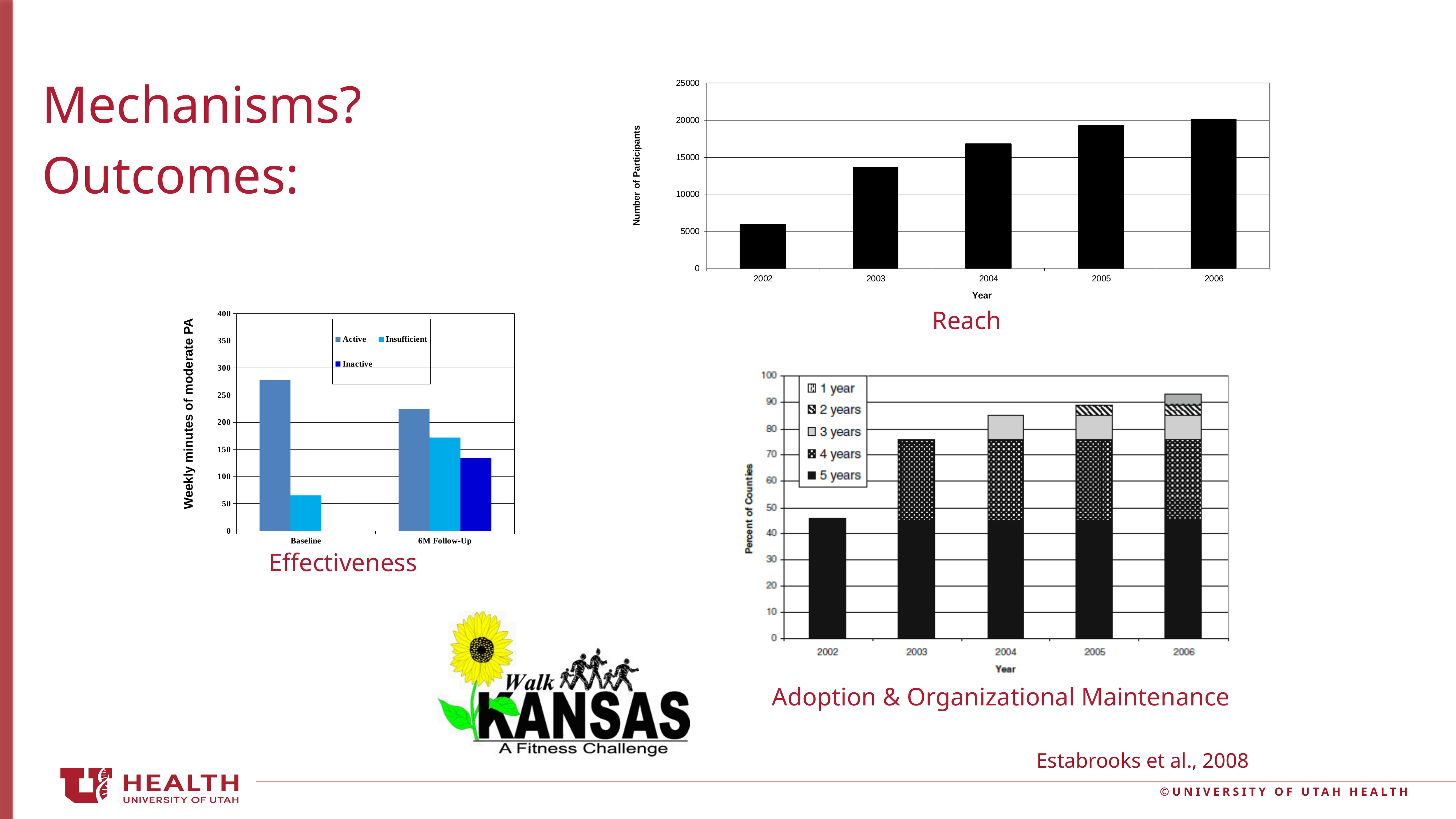
In the Reach chart, which year has the highest number of participants? 2006 In the Reach chart, which year has the lowest number of participants? 2002 How many series does the legend of the Effectiveness chart list? 3 How many series does the legend of the Adoption & Organizational Maintenance chart list? 5 In the Effectiveness chart, at 6M Follow-Up, which is larger: Active or Inactive? Active What kind of chart is the Adoption & Organizational Maintenance chart? stacked bar chart How many years are shown on the x axis of the Reach chart? 5 In the Reach chart, is the number of participants in 2004 greater or less than 15000? greater In the Reach chart, is the number of participants in 2002 greater or less than 10000? less In the Reach chart, do the number of participants rise or fall from 2002 to 2006? rise In the Effectiveness chart, is the value for Active at Baseline greater or less than 250? greater